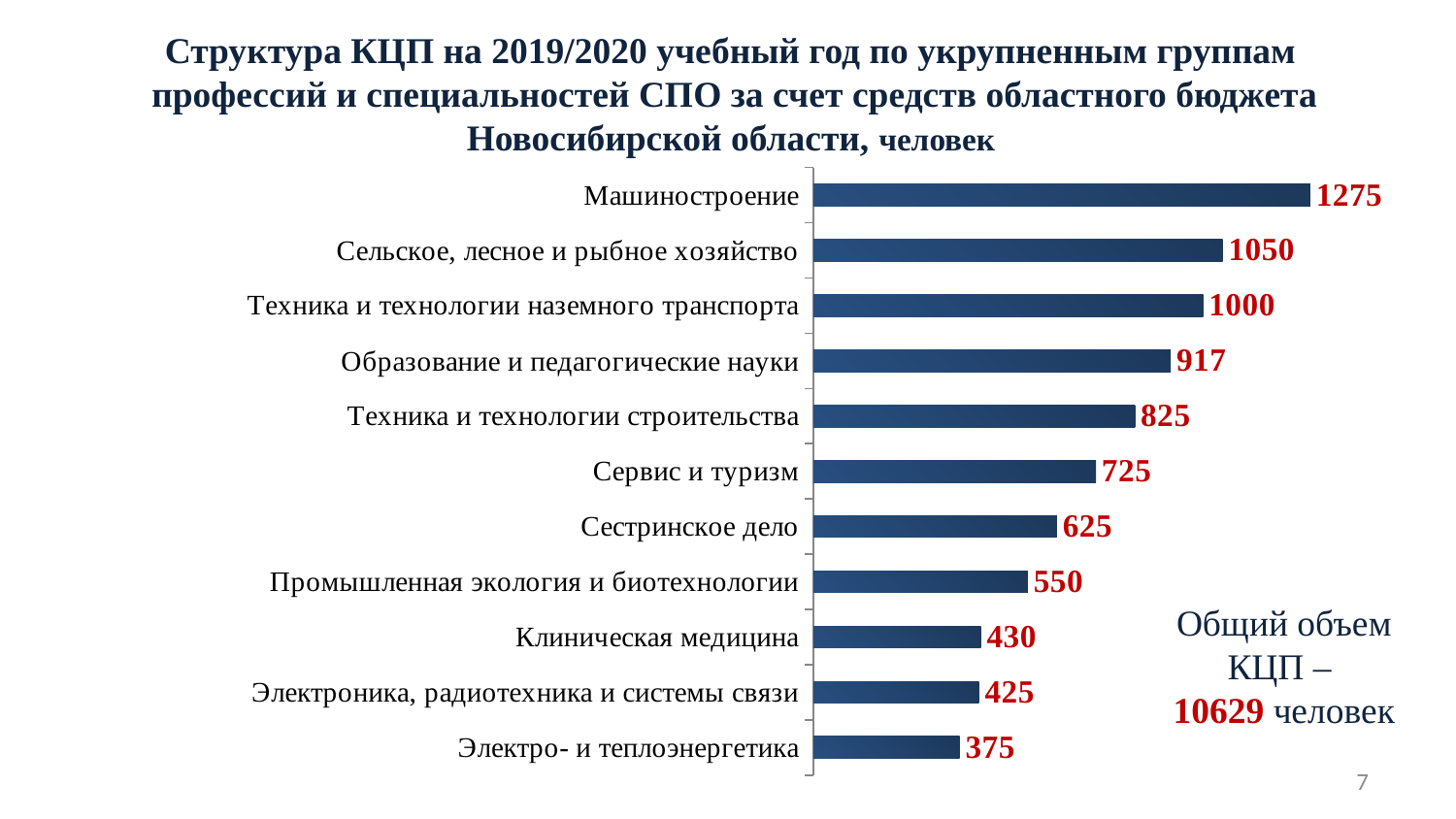
What is the difference between the values for Машиностроение and Сельское, лесное и рыбное хозяйство? 225 Which is larger: the value for Образование и педагогические науки or the value for Техника и технологии строительства? Образование и педагогические науки Which category has the highest value? Машиностроение What is the value for Электро- и теплоэнергетика? 375 How many categories are shown in the chart? 11 What is the value for Сестринское дело? 625 What total volume of КЦП is stated on the slide? 10629 человек Which category has the lowest value? Электро- и теплоэнергетика What is the difference between the values for Сервис и туризм and Промышленная экология и биотехнологии? 175 What is the value for Техника и технологии наземного транспорта? 1000 What kind of chart is shown on the slide? Bar chart What is the value for Машиностроение? 1275